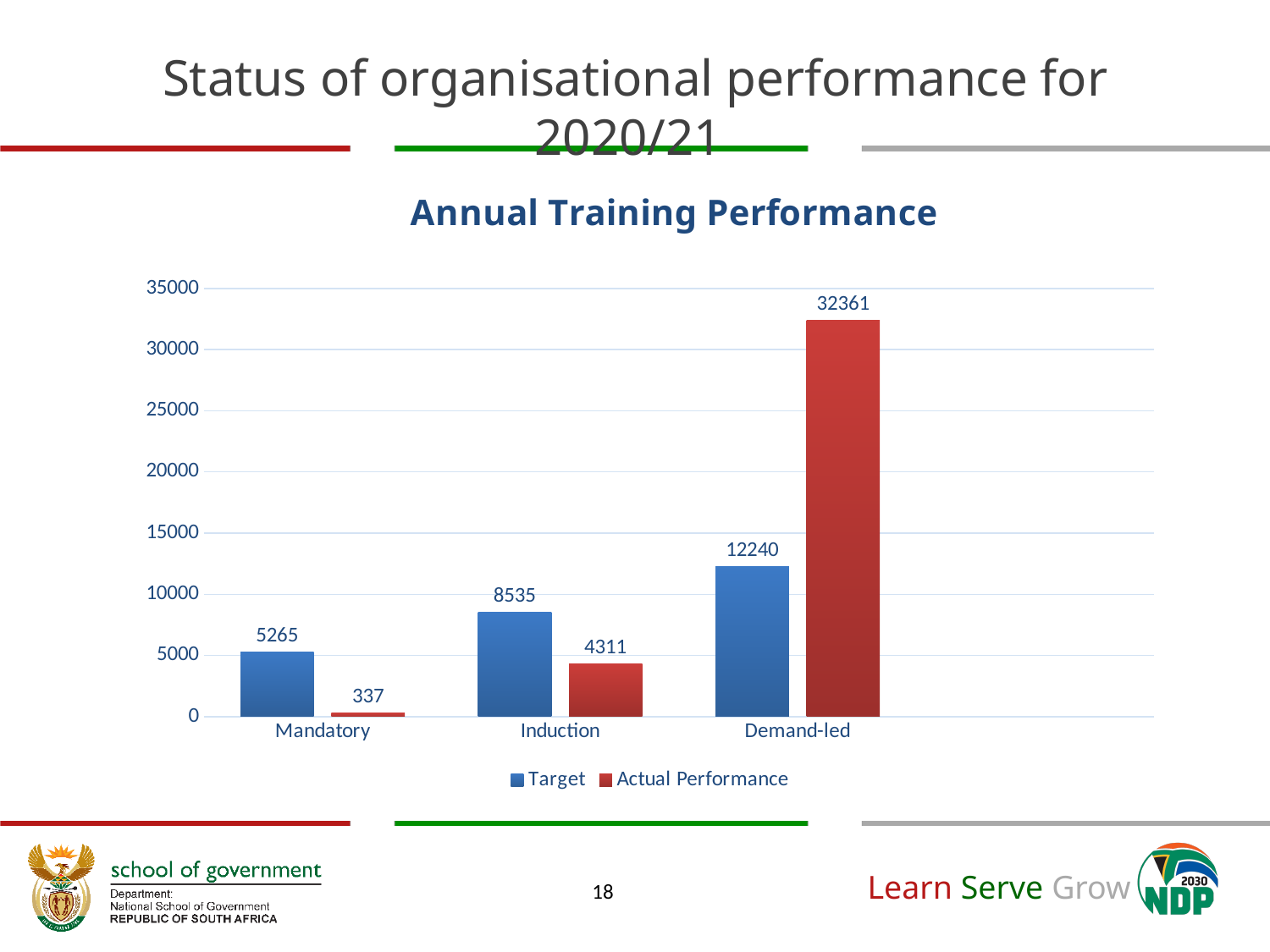
What is the Actual Performance value for Mandatory? 337 Is the Target value for Demand-led greater or less than 10000? greater What is the difference between the Target and Actual Performance for Mandatory? 4928 What is the difference between Actual Performance and Target for Demand-led? 20121 What is the Target value for Induction? 8535 Which category has the lowest Actual Performance value? Mandatory Which category has the highest Target value? Demand-led How many categories are shown on the x axis? 3 What is the Actual Performance value for Demand-led? 32361 Which is larger for Induction, the Target or the Actual Performance? Target How many series does the legend list? 2 What type of chart is shown? Bar chart